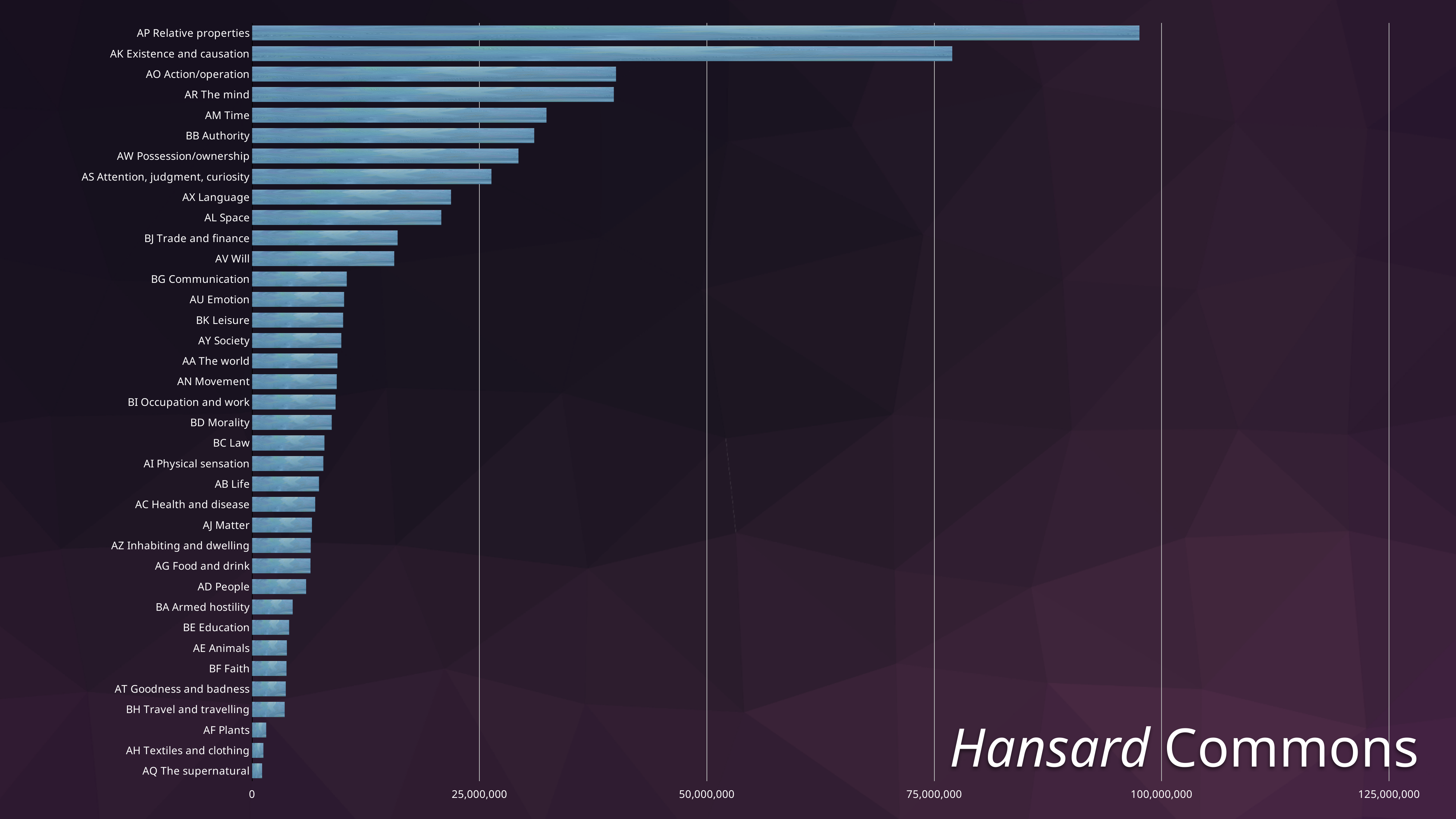
What text is shown in large letters at the bottom right of the chart? Hansard Commons What kind of chart is shown on the slide? bar chart Which is larger, the value for AO Action/operation or AX Language? AO Action/operation Do the bar values increase or decrease from the top of the chart to the bottom? decrease How many categories are plotted on the chart? 37 Is the value for AO Action/operation greater or less than 25,000,000? greater Which category has the highest value? AP Relative properties Is the value for AK Existence and causation greater or less than 100,000,000? less Which is larger, the value for AP Relative properties or AK Existence and causation? AP Relative properties Is the value for AX Language greater or less than 25,000,000? less